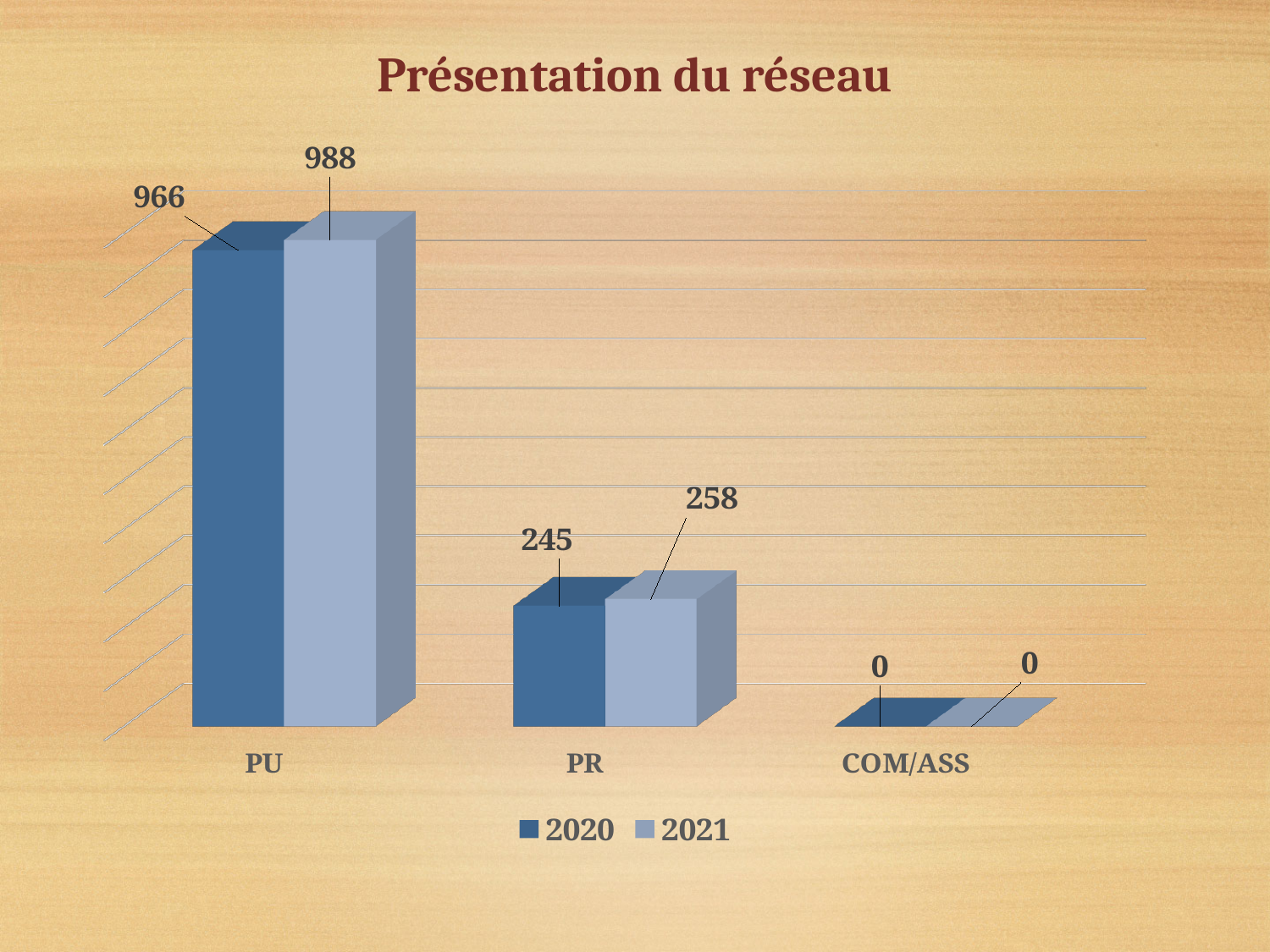
What is the difference between the 2021 and 2020 values for PR? 13 What is the value for PU in 2021? 988 What is the value for PR in 2020? 245 What is the value for COM/ASS in 2021? 0 Which is larger for PR: the 2020 value or the 2021 value? 2021 What is the value for PU in 2020? 966 Which category has the lowest value in 2020? COM/ASS How many series does the legend list? 2 What is the difference between the 2021 and 2020 values for PU? 22 How many categories are shown on the x axis? 3 What is the value for PR in 2021? 258 Which category has the highest value in 2021? PU